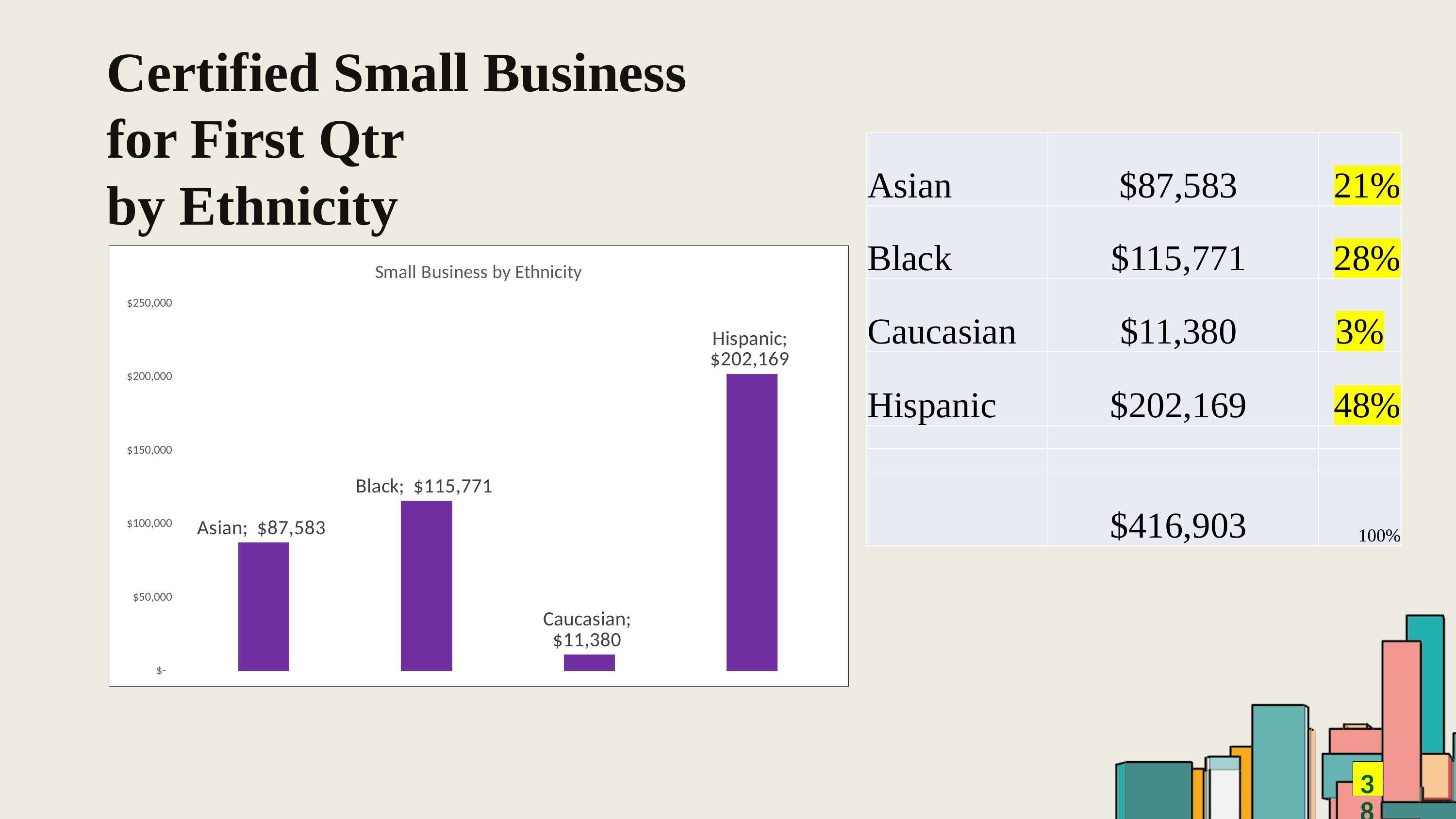
How many ethnicity categories are shown in the chart? 4 What is the value for Asian in the Small Business by Ethnicity chart? $87,583 What is the value for Black in the Small Business by Ethnicity chart? $115,771 What is the value for Caucasian in the Small Business by Ethnicity chart? $11,380 Which is larger in the chart, the value for Asian or the value for Black? Black What is the value for Hispanic in the Small Business by Ethnicity chart? $202,169 What type of chart is shown on the slide? Bar chart What is the difference between the Hispanic and Black values in the chart? $86,398 What is the difference between the Black and Asian values in the chart? $28,188 Which ethnicity has the lowest value in the chart? Caucasian Is the value for Hispanic greater or less than $200,000? greater Which ethnicity has the highest value in the chart? Hispanic